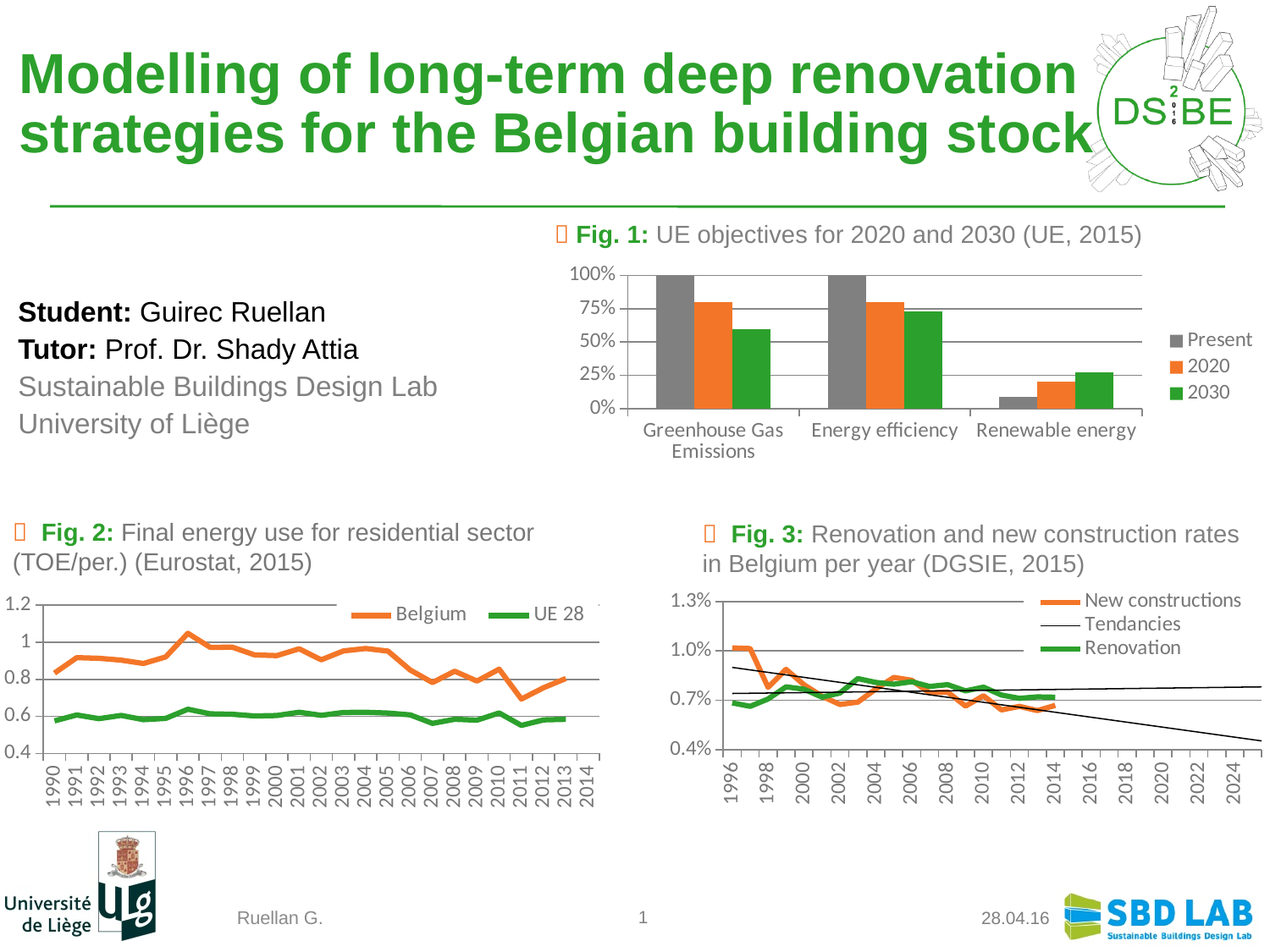
In Fig. 1 (UE objectives for 2020 and 2030), for Renewable energy, which is larger: the 2020 value or the 2030 value? 2030 In Fig. 1 (UE objectives for 2020 and 2030), is the 2030 value for Greenhouse Gas Emissions greater or less than 75%? less In Fig. 3 (Renovation and new construction rates in Belgium per year), is the New constructions value in 1996 greater or less than 0.7%? greater In Fig. 2 (Final energy use for residential sector), which series has the higher value in 2000: Belgium or UE 28? Belgium In Fig. 1 (UE objectives for 2020 and 2030), is the Present value for Renewable energy greater or less than 25%? less In Fig. 1 (UE objectives for 2020 and 2030), what kind of chart is shown? bar chart In Fig. 3 (Renovation and new construction rates in Belgium per year), does the New constructions line rise or fall from 1996 to 2014? fall In Fig. 1 (UE objectives for 2020 and 2030), how many series does the legend list? 3 In Fig. 1 (UE objectives for 2020 and 2030), how many categories are shown on the x axis? 3 In Fig. 1 (UE objectives for 2020 and 2030), which series has the lowest value for Renewable energy? Present In Fig. 2 (Final energy use for residential sector), how many series does the legend list? 2 In Fig. 1 (UE objectives for 2020 and 2030), what is the Present value for Greenhouse Gas Emissions? 100%